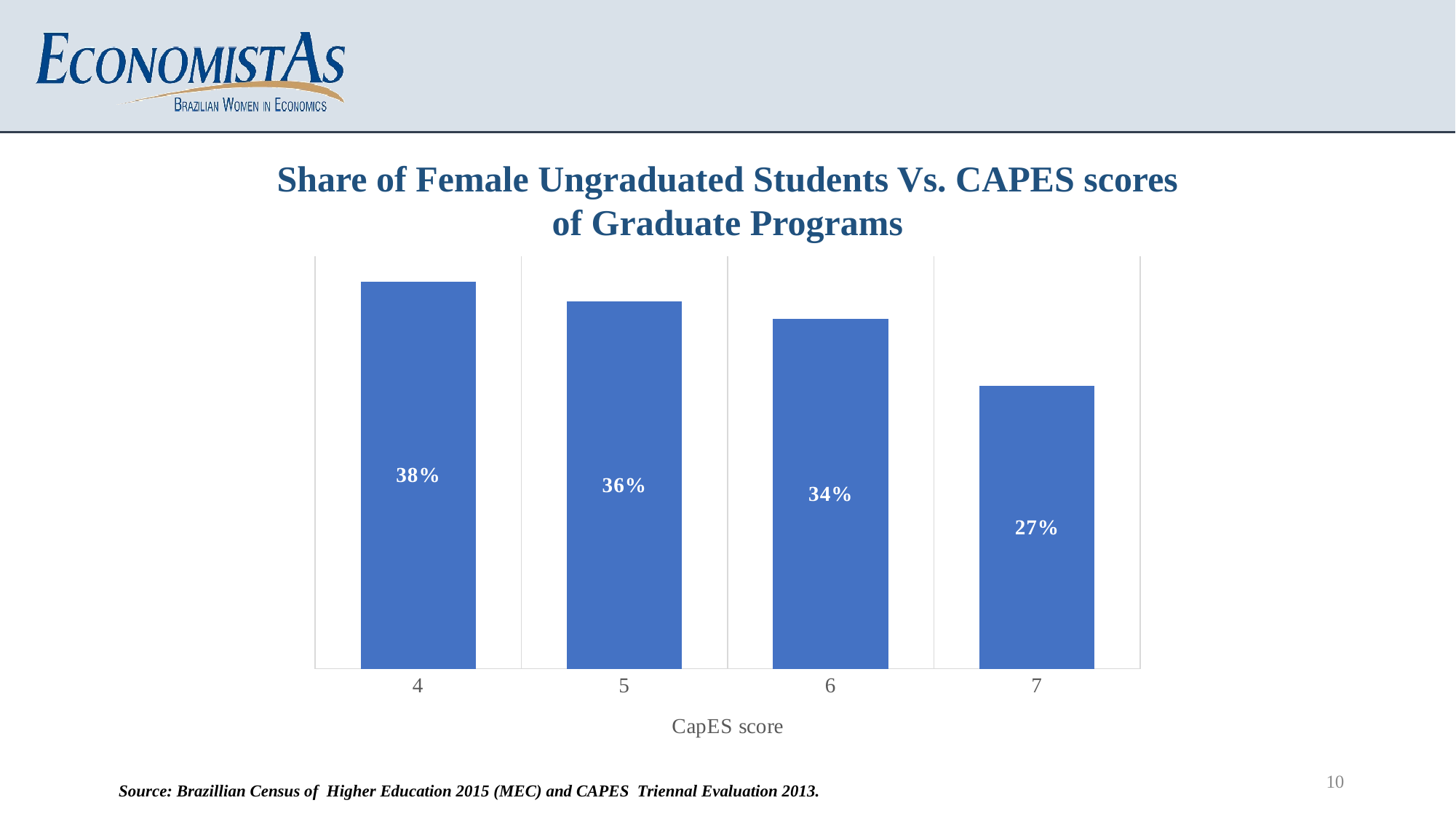
What kind of chart is shown on the slide? Bar chart What is the difference between the shares for CAPES score 4 and CAPES score 7? 11% What is the value shown for CAPES score 6? 34% What is the label of the x axis of the chart? CapES score How many CAPES score categories are shown in the chart? 4 Which has a larger share of female undergraduate students, CAPES score 5 or CAPES score 7? CAPES score 5 What is the share of female undergraduate students for programs with a CAPES score of 4? 38% What is the share of female undergraduate students for programs with a CAPES score of 7? 27% Which CAPES score has the highest share of female undergraduate students? 4 Do the values rise or fall as the CAPES score increases from 4 to 7? Fall What is the difference between the shares for CAPES score 5 and CAPES score 6? 2% Which CAPES score has the lowest share of female undergraduate students? 7